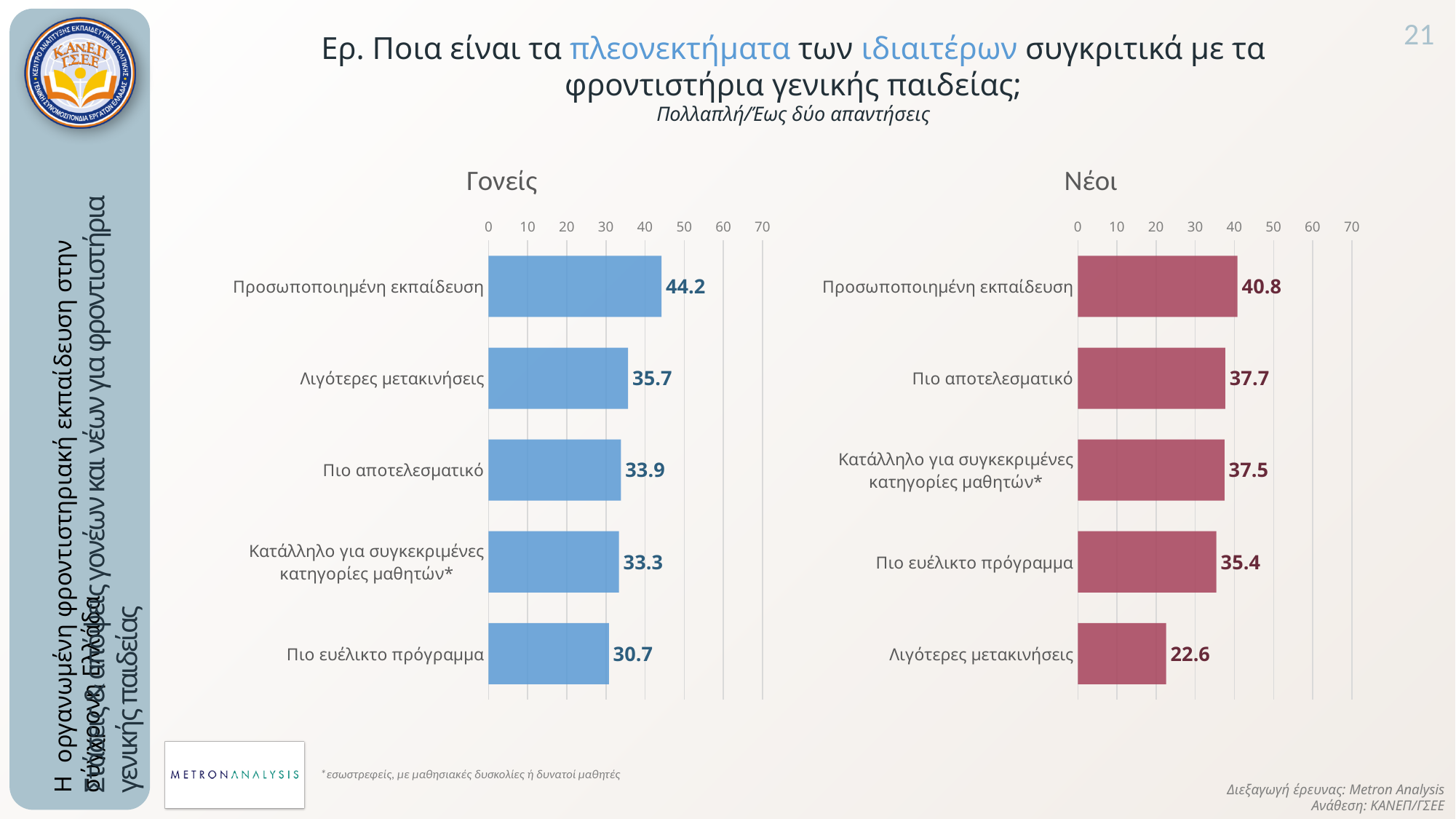
In the Γονείς chart, what is the value for Προσωποποιημένη εκπαίδευση? 44.2 In the Νέοι chart, which category has the highest value? Προσωποποιημένη εκπαίδευση In the Νέοι chart, what is the difference between Πιο αποτελεσματικό and Λιγότερες μετακινήσεις? 15.1 How many categories does the Νέοι chart show? 5 In the Γονείς chart, is the value for Προσωποποιημένη εκπαίδευση greater or less than 40? greater In the Νέοι chart, what is the value for Λιγότερες μετακινήσεις? 22.6 Which is larger: the value for Πιο αποτελεσματικό in the Γονείς chart or in the Νέοι chart? Νέοι In the Γονείς chart, which category has the lowest value? Πιο ευέλικτο πρόγραμμα What kind of chart is the Γονείς chart? bar chart In the Νέοι chart, what is the value for Πιο ευέλικτο πρόγραμμα? 35.4 In the Γονείς chart, what is the difference between Προσωποποιημένη εκπαίδευση and Λιγότερες μετακινήσεις? 8.5 What colour are the bars in the Νέοι chart? red